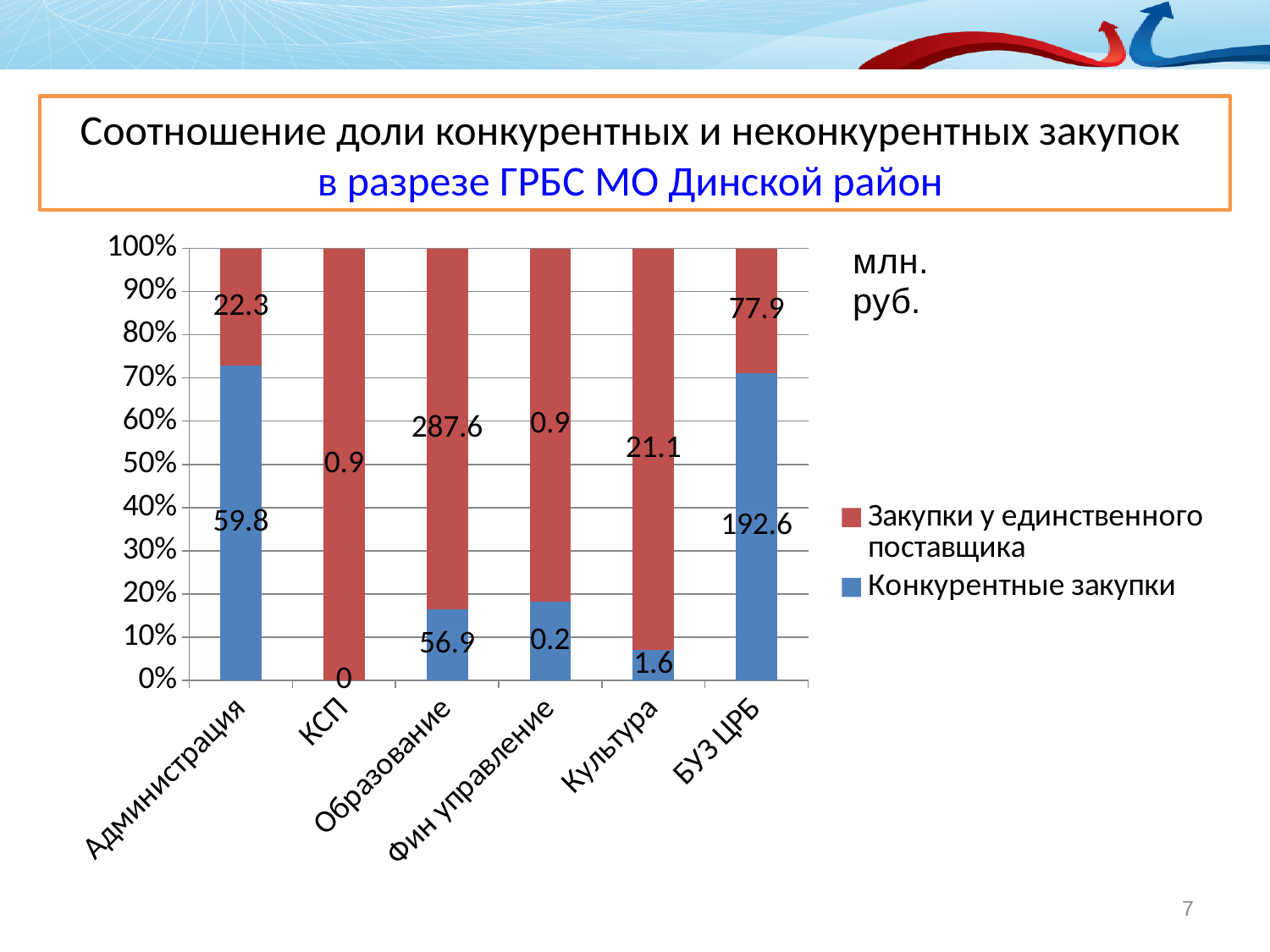
Is the share of Конкурентные закупки for Образование greater or less than 20%? less What is the value of Закупки у единственного поставщика for Образование? 287.6 What is the value of Закупки у единственного поставщика for Культура? 21.1 What is the value of Конкурентные закупки for Администрация? 59.8 Which category has the lowest value for Конкурентные закупки? КСП How many categories are shown on the x axis? 6 Which is larger for БУЗ ЦРБ: Конкурентные закупки or Закупки у единственного поставщика? Конкурентные закупки Which category has the highest value for Закупки у единственного поставщика? Образование What is the difference between Закупки у единственного поставщика and Конкурентные закупки for Образование? 230.7 What is the value of Конкурентные закупки for БУЗ ЦРБ? 192.6 How many series does the legend list? 2 What is the total of the two series for Администрация? 82.1